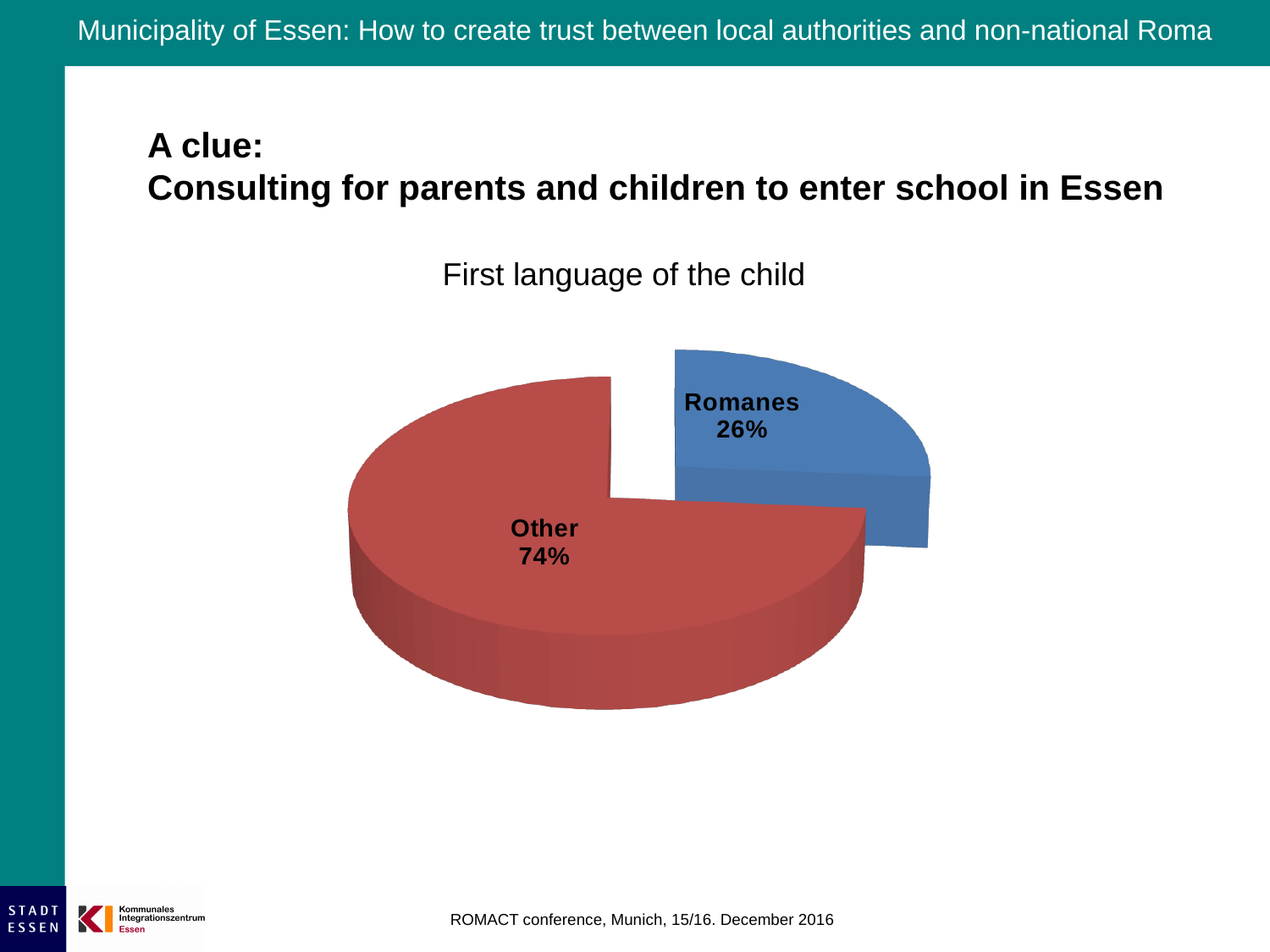
What colour is the Romanes slice? blue What share of the pie is labelled Other? 74% Which slice of the pie is the smallest? Romanes What is the title of the chart? First language of the child What kind of chart is shown on the slide? pie chart Which is larger, the Romanes slice or the Other slice? Other How many slices does the pie chart have? 2 What is the total of the two slice percentages shown? 100% Which slice of the pie is the largest? Other What is the difference in percentage points between the Other slice and the Romanes slice? 48 What share of the pie is labelled Romanes? 26%